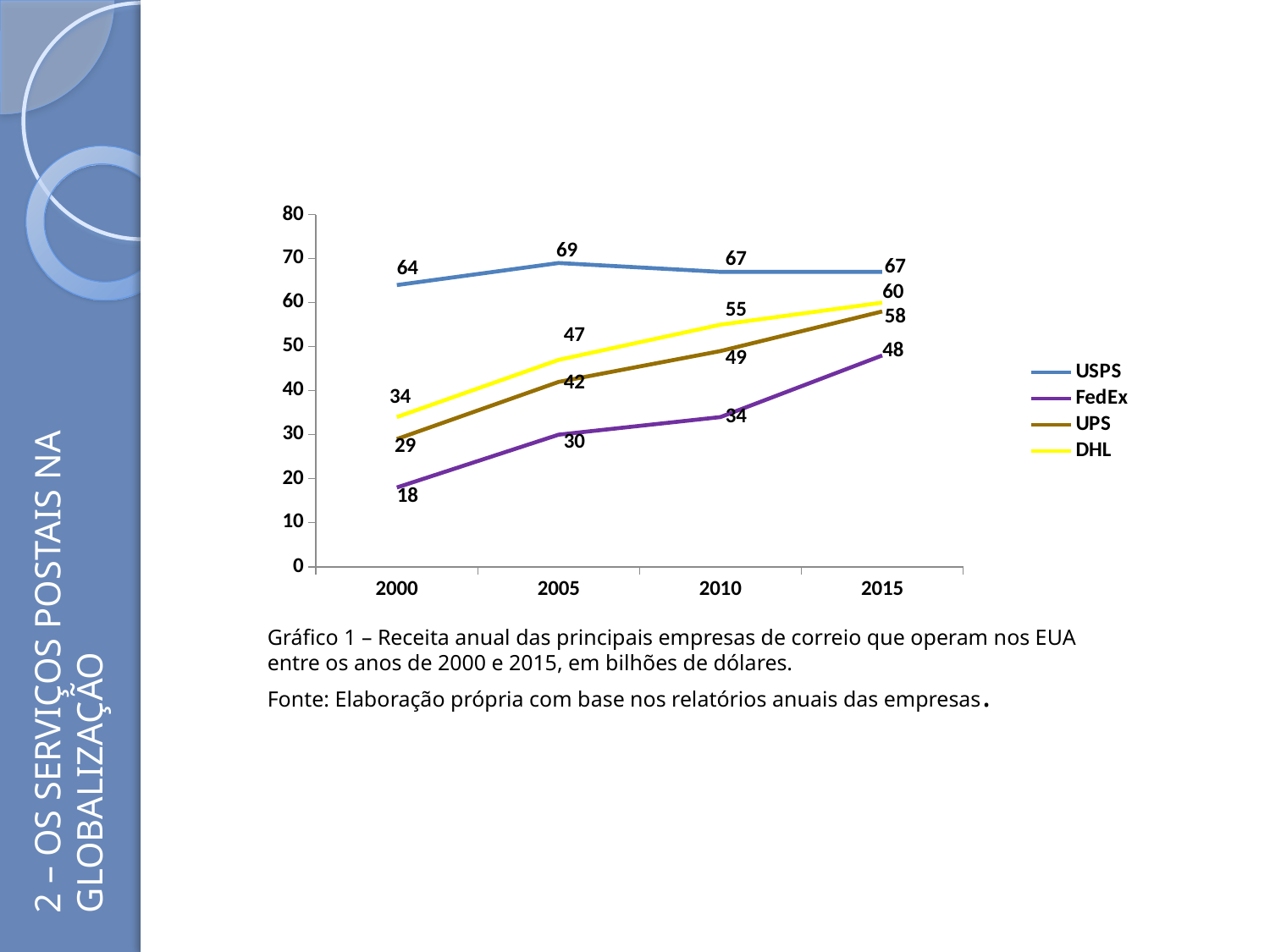
Which series has the lowest value in 2000? FedEx Do the FedEx values rise or fall from 2000 to 2015? rise What is the difference between the DHL and UPS values in 2005? 5 What is the value for UPS in 2010? 49 What is the value for DHL in 2015? 60 What is the value for FedEx in 2000? 18 What is the value for USPS in 2005? 69 Which series has the highest value in 2015? USPS How many years are shown on the x axis? 4 How many series does the legend list? 4 What kind of chart is shown on the slide? line chart Which is larger, the FedEx value in 2015 or the UPS value in 2010? UPS value in 2010